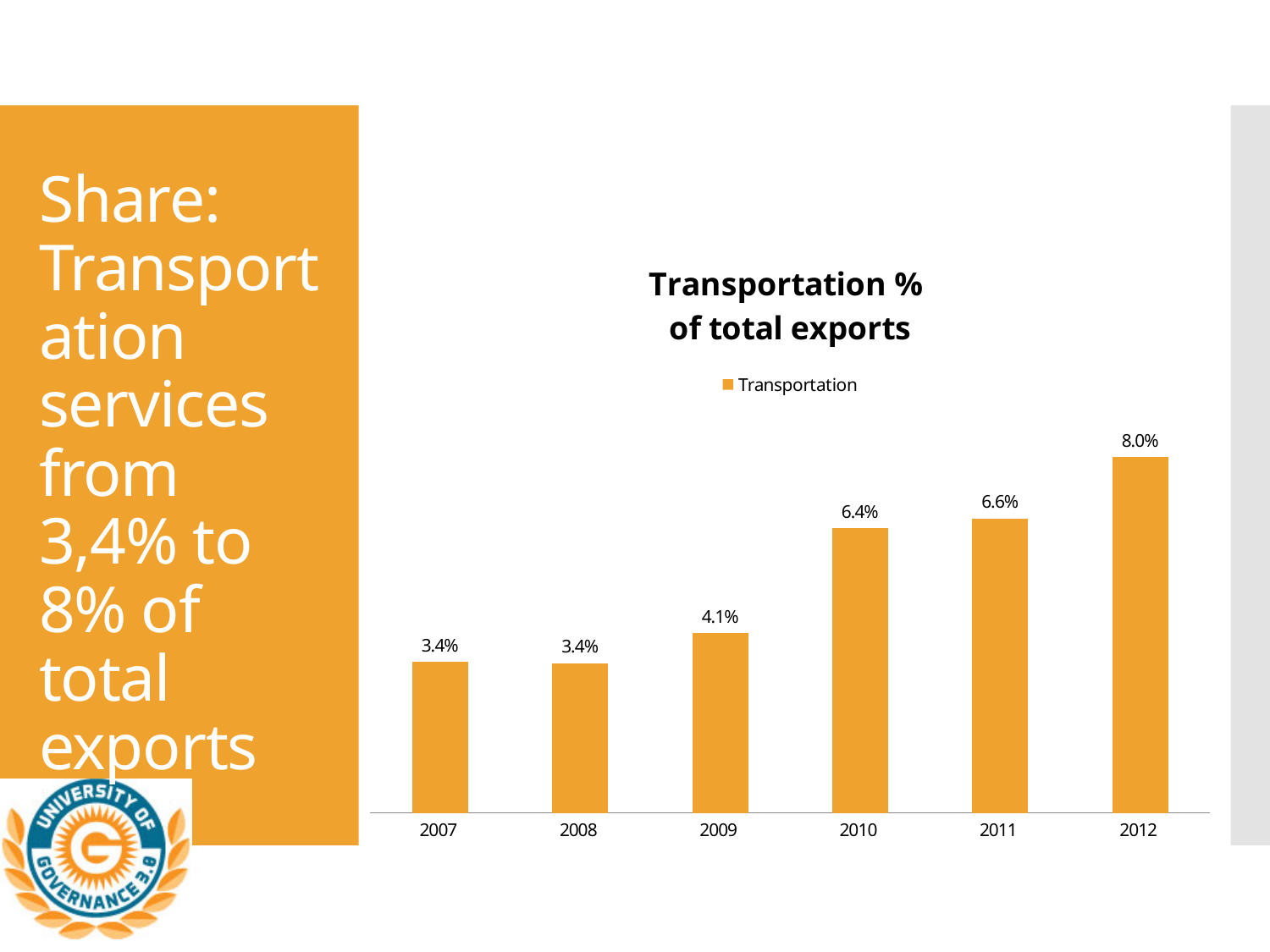
How many series does the legend list? 1 What is the title of the chart? Transportation % of total exports Which is larger, the value for 2010 or the value for 2011? 2011 What kind of chart is shown on the slide? Bar chart Do the values rise or fall from 2007 to 2012? Rise What is the difference between the 2010 value and the 2009 value? 2.3% What is the difference between the 2012 value and the 2007 value? 4.6% What is the Transportation value for 2009? 4.1% What is the Transportation value for 2011? 6.6% What is the Transportation value for 2007? 3.4% Which year has the highest Transportation share of total exports? 2012 How many years are shown on the x axis? 6